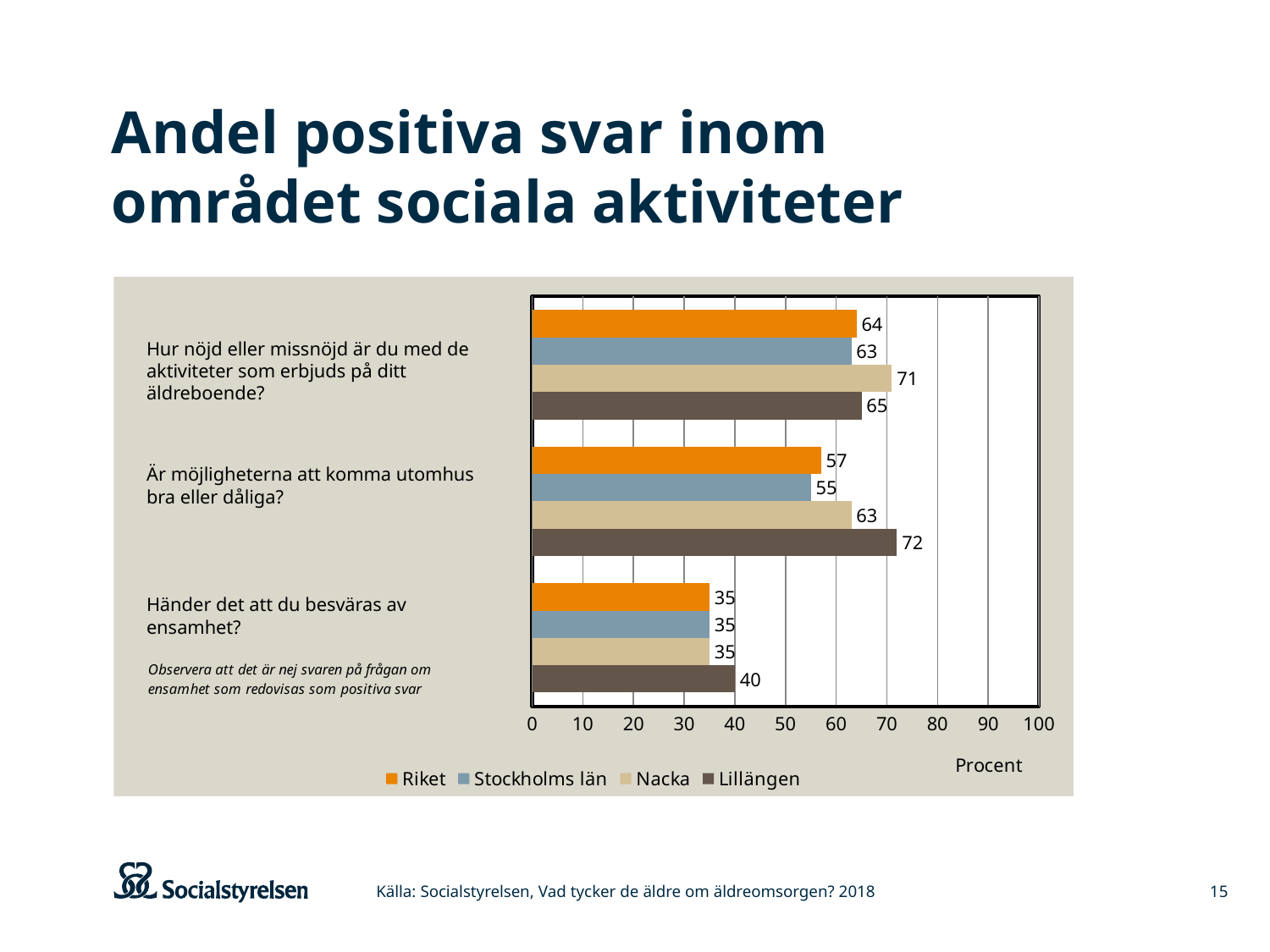
What is the difference between Nacka and Riket on the question "Hur nöjd eller missnöjd är du med de aktiviteter som erbjuds på ditt äldreboende?"? 7 How many series does the legend list? 4 What kind of chart is shown on the slide? Bar chart What is the difference between Lillängen and Riket on the question "Är möjligheterna att komma utomhus bra eller dåliga?"? 15 Which series has the highest value on the question "Är möjligheterna att komma utomhus bra eller dåliga?"? Lillängen What unit is shown on the horizontal axis of the chart? Procent What is the value for Nacka on the question "Hur nöjd eller missnöjd är du med de aktiviteter som erbjuds på ditt äldreboende?"? 71 How many questions (categories) are shown on the chart? 3 Which is larger on the question "Händer det att du besväras av ensamhet?": Lillängen or Nacka? Lillängen What is the value for Lillängen on the question "Är möjligheterna att komma utomhus bra eller dåliga?"? 72 What is the value for Stockholms län on the question "Händer det att du besväras av ensamhet?"? 35 Which series has the lowest value on the question "Hur nöjd eller missnöjd är du med de aktiviteter som erbjuds på ditt äldreboende?"? Stockholms län